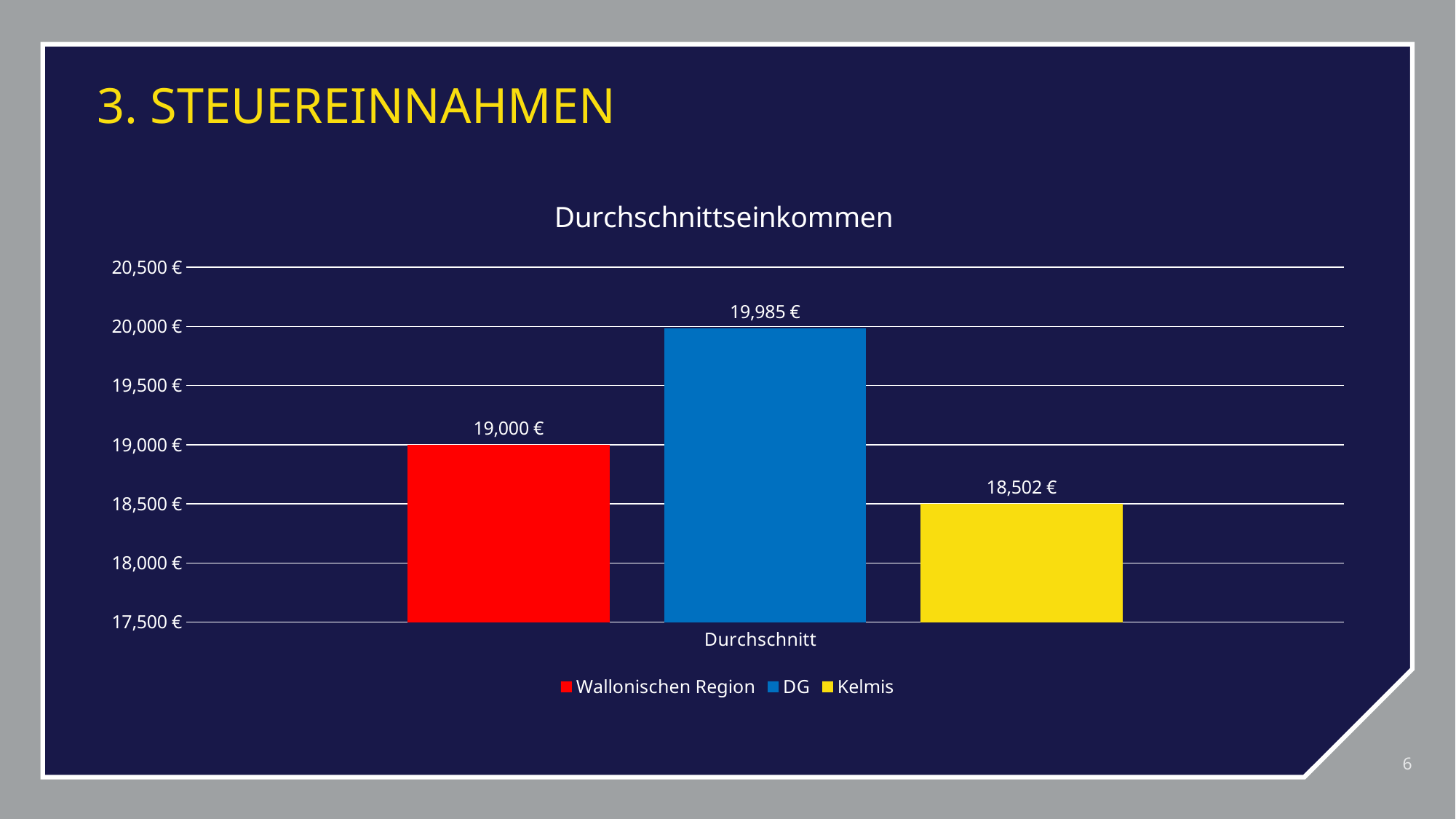
What is the value for Kelmis in the Durchschnittseinkommen chart? 18,502 € What is the value for Wallonischen Region in the Durchschnittseinkommen chart? 19,000 € What is the title of the chart? Durchschnittseinkommen Which series has the highest value in the Durchschnittseinkommen chart? DG What is the difference between the DG value and the Wallonischen Region value? 985 € Which is larger, the value for Wallonischen Region or the value for Kelmis? Wallonischen Region How many series does the legend list? 3 What is the difference between the DG value and the Kelmis value? 1,483 € What is the value for DG in the Durchschnittseinkommen chart? 19,985 € Which series has the lowest value in the Durchschnittseinkommen chart? Kelmis What kind of chart is shown on the slide? bar chart Is the value for DG greater or less than 19,500 €? greater